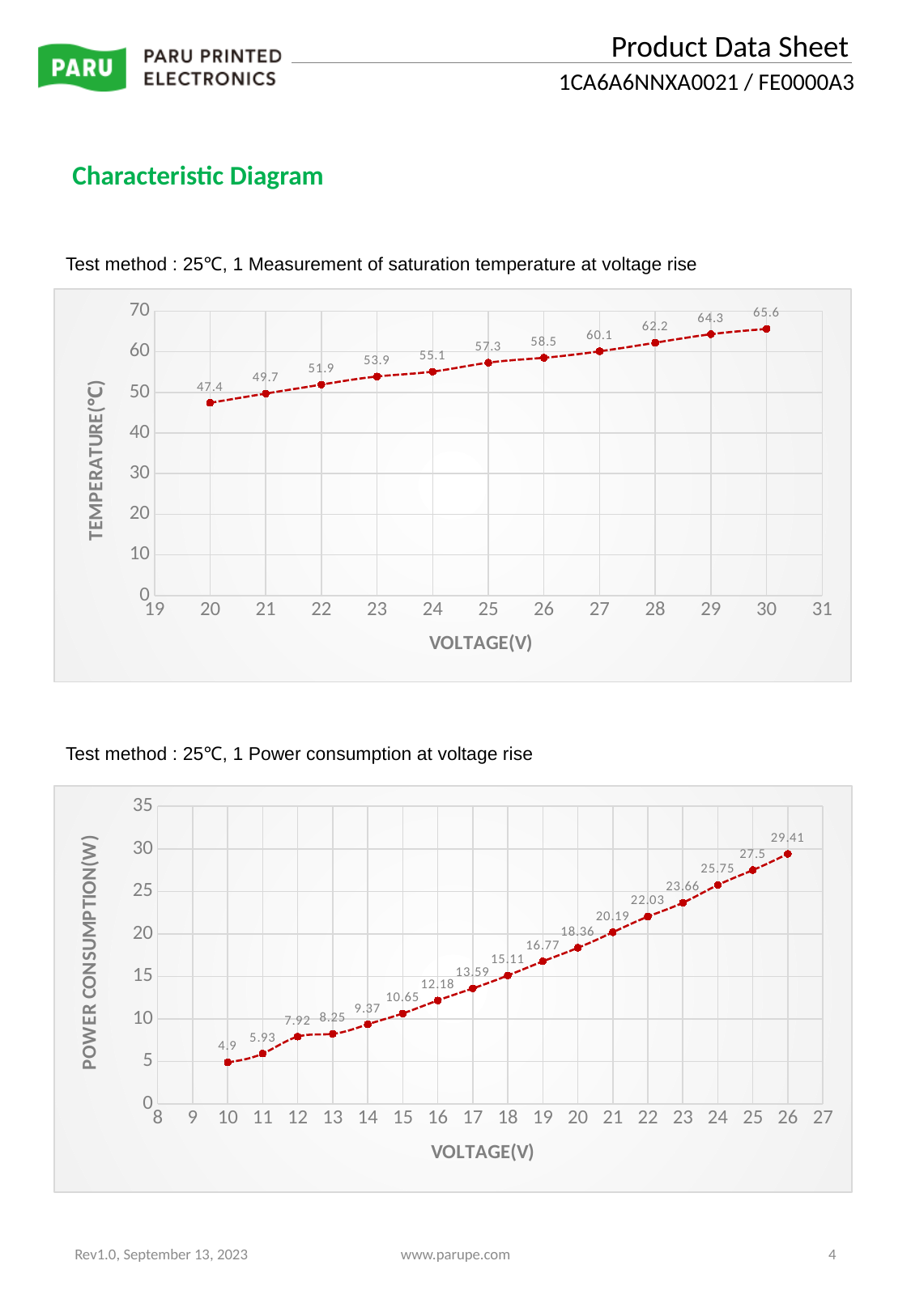
In the bottom chart (power consumption at voltage rise), at which voltage is the power consumption lowest? 10 In the top chart (saturation temperature at voltage rise), what is the difference between the temperature at 30 V and at 20 V? 18.2 In the top chart (saturation temperature at voltage rise), how many data points are plotted? 11 In the bottom chart (power consumption at voltage rise), how many data points are plotted? 17 In the top chart (saturation temperature at voltage rise), what is the temperature at 25 V? 57.3 In the bottom chart (power consumption at voltage rise), which is larger: the power consumption at 22 V or at 16 V? 22 V In the bottom chart (power consumption at voltage rise), what is the power consumption at 18 V? 15.11 In the top chart (saturation temperature at voltage rise), what is the temperature at 20 V? 47.4 What type of chart is the bottom chart (power consumption at voltage rise)? line chart In the top chart (saturation temperature at voltage rise), at which voltage is the temperature highest? 30 In the bottom chart (power consumption at voltage rise), what is the power consumption at 26 V? 29.41 In the top chart (saturation temperature at voltage rise), does the temperature rise or fall as voltage increases? rise